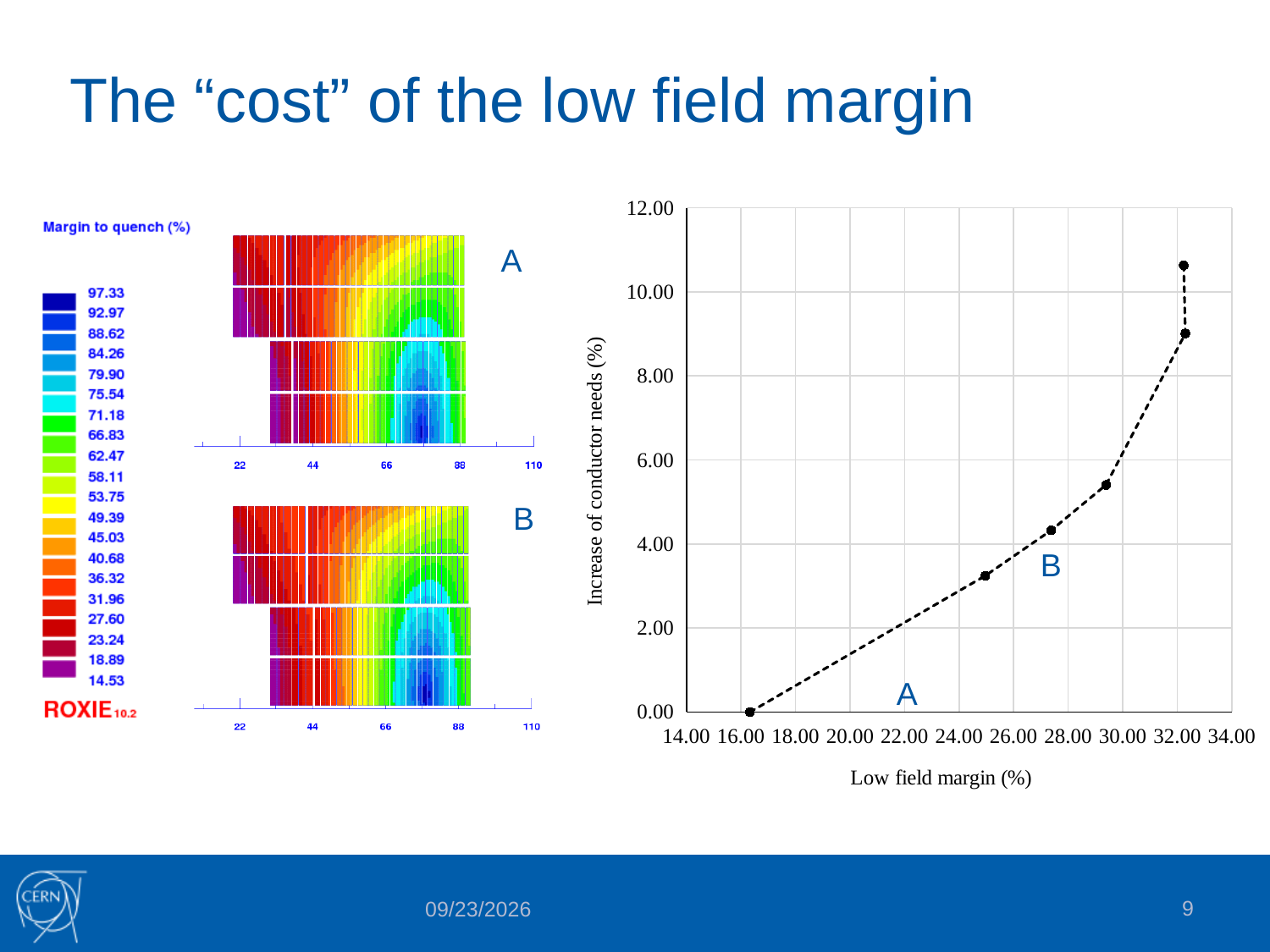
In the chart on the right, which labelled point, A or B, has the smaller low field margin? A In the chart on the right, what is the label of the y axis? Increase of conductor needs (%) In the chart on the right, is the highest plotted increase of conductor needs greater or less than 10.00? greater In the chart on the right, is the increase of conductor needs for point B greater or less than 2.00? greater What kind of chart is shown on the right of the slide? line chart In the chart on the right, does the increase of conductor needs rise or fall as the low field margin increases? rise In the chart on the right, what is the highest value shown on the y axis? 12.00 How many data points are plotted in the chart on the right? 6 In the chart on the right, which labelled point, A or B, has the larger increase of conductor needs? B In the chart on the right, what is the label of the x axis? Low field margin (%)